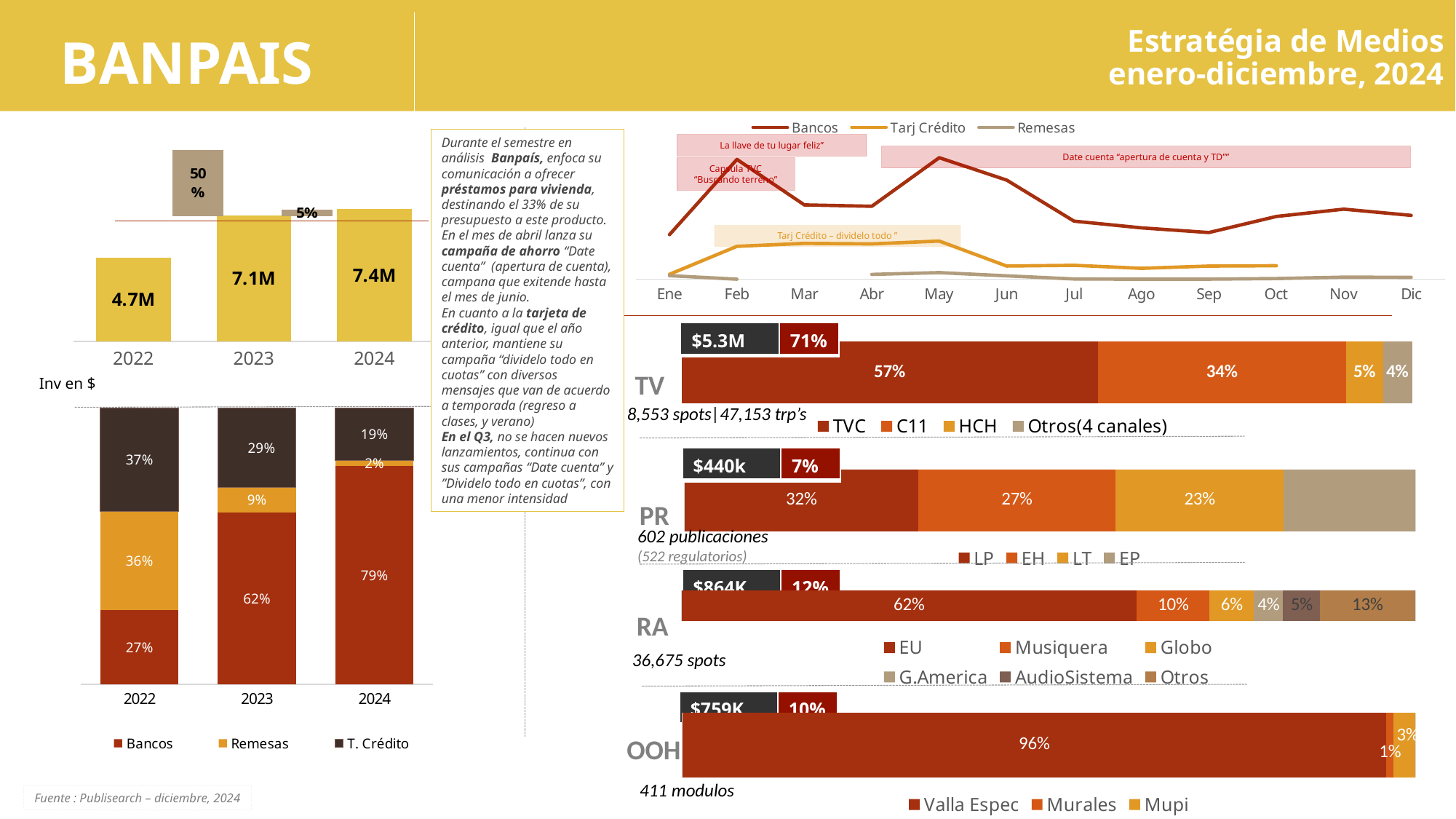
In the RA bar on the right, which station has the highest share? EU In the stacked bar chart at the bottom left, what is the Remesas share for 2022? 36% In the stacked bar chart at the bottom left, how many series does the legend list? 3 In the 'Inv en $' bar chart on the left, which year has the lowest investment? 2022 In the line chart at the top right, how many months are shown on the x axis? 12 In the line chart at the top right, what kind of chart is it? Line chart In the OOH bar on the right, what is the share for Mupi? 3% In the stacked bar chart at the bottom left, what is the Bancos share for 2024? 79% In the stacked bar chart at the bottom left, what is the difference between the Bancos share in 2023 and in 2022? 35% In the 'Inv en $' bar chart on the left, how many years are shown? 3 In the 'Inv en $' bar chart on the left, what is the value for 2024? 7.4M In the TV bar on the right, what is the share for C11? 34%